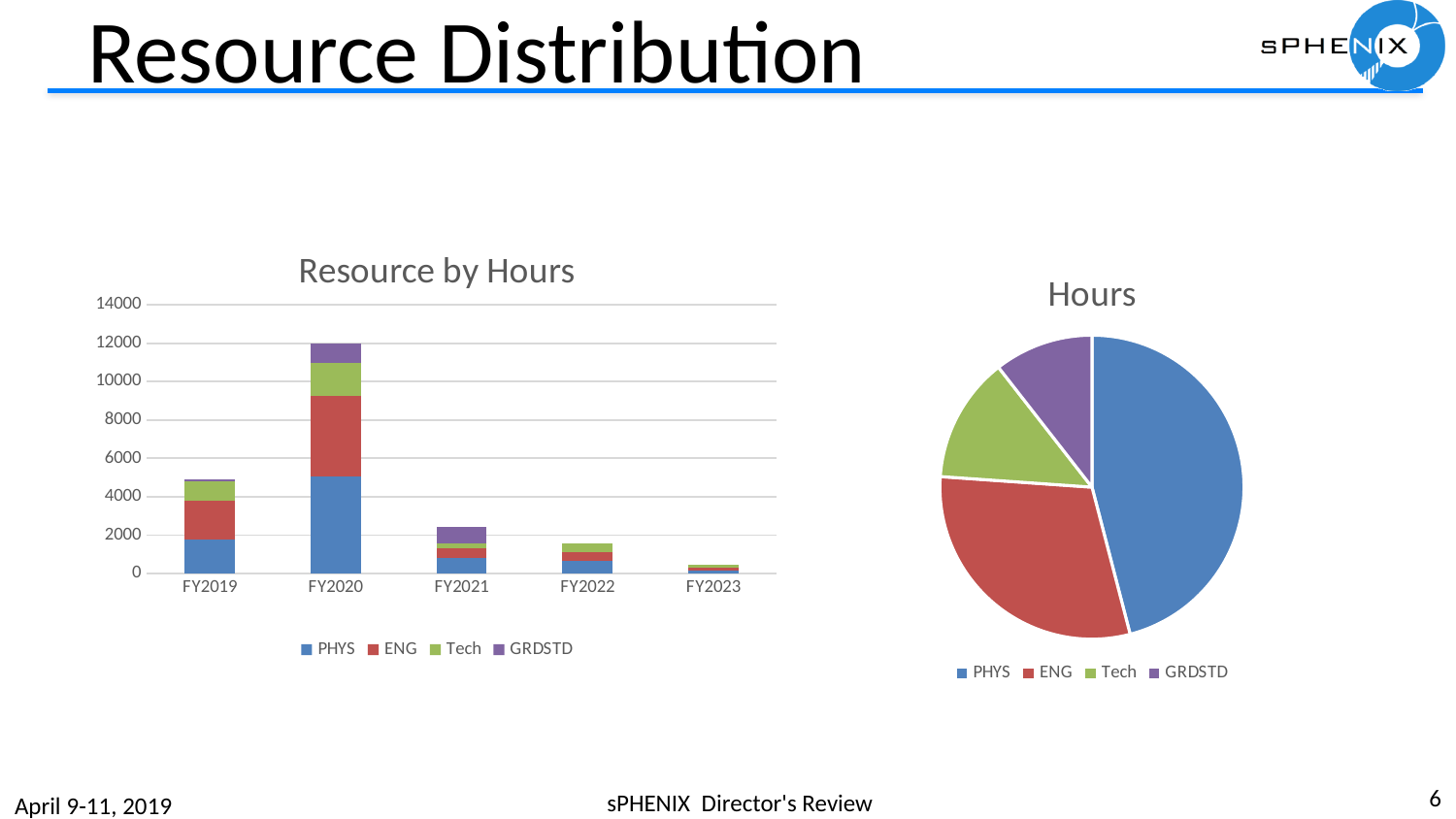
What kind of chart is the "Hours" chart? pie chart In the "Hours" pie chart, which slice is larger, ENG or Tech? ENG In the "Hours" pie chart, which category has the largest slice? PHYS In the "Resource by Hours" chart, which fiscal year has the lowest total hours? FY2023 In the "Resource by Hours" chart, how many series does the legend list? 4 In the "Resource by Hours" chart, is the total for FY2020 greater or less than 10000? greater In the "Resource by Hours" chart, is the total for FY2019 greater or less than 6000? less In the "Resource by Hours" chart, which fiscal year has the highest total hours? FY2020 What kind of chart is the "Resource by Hours" chart? stacked bar chart In the "Resource by Hours" chart, how many fiscal years are shown on the x axis? 5 In the "Resource by Hours" chart, is the total for FY2022 greater or less than 2000? less In the "Resource by Hours" chart, do the total hours rise or fall from FY2020 to FY2023? fall